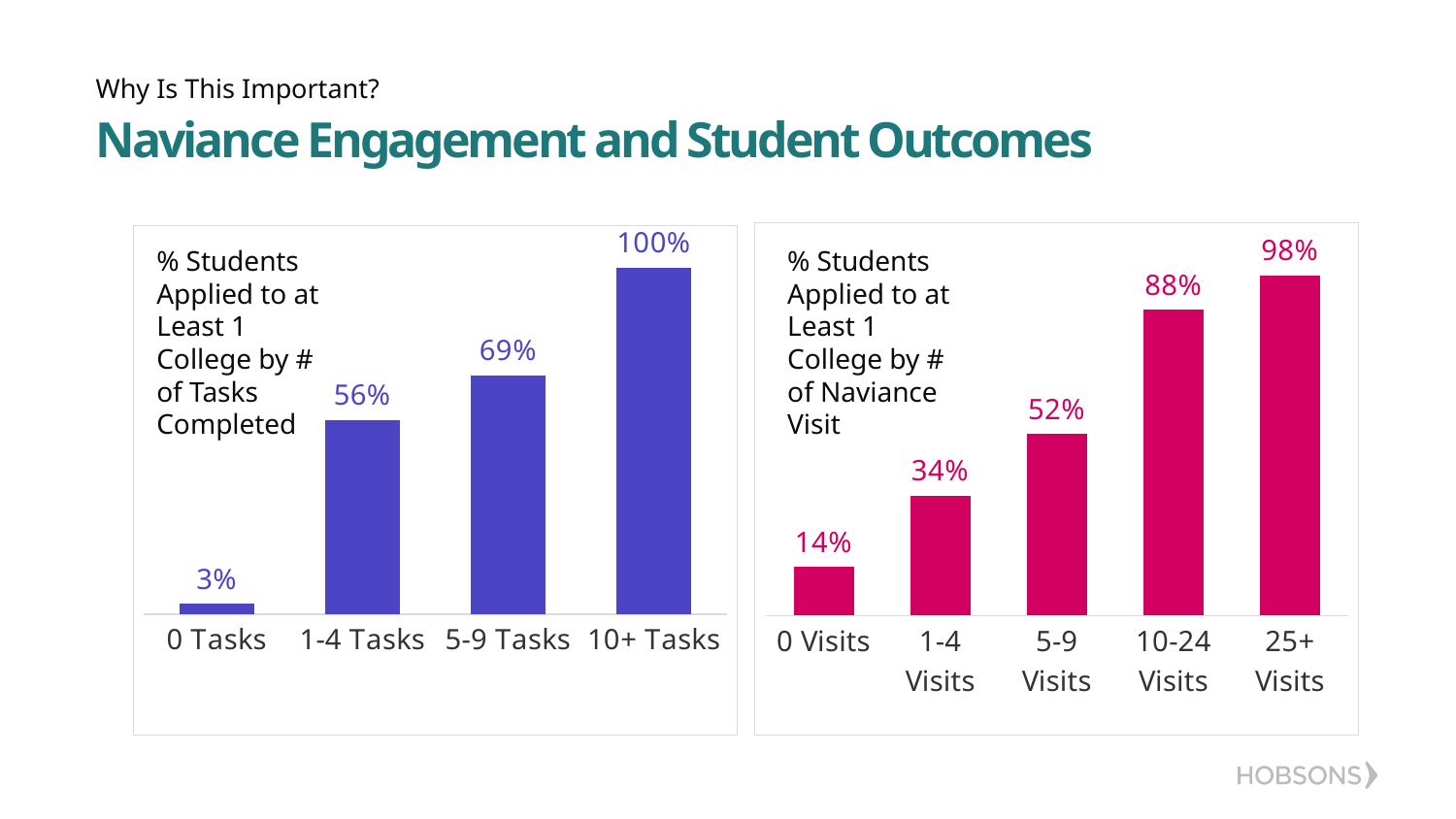
In the right chart (by # of Naviance Visit), what is the difference between the values for 10-24 Visits and 1-4 Visits? 54% In the right chart (% Students Applied to at Least 1 College by # of Naviance Visit), what is the value for 5-9 Visits? 52% What type of chart is the right chart (by # of Naviance Visit)? bar chart How many categories are shown in the left chart (by # of Tasks Completed)? 4 In the left chart (by # of Tasks Completed), which category has the lowest value? 0 Tasks In the left chart (by # of Tasks Completed), what is the difference between the values for 10+ Tasks and 5-9 Tasks? 31% What colour are the bars in the left chart (by # of Tasks Completed)? purple In the left chart (% Students Applied to at Least 1 College by # of Tasks Completed), what is the value for 1-4 Tasks? 56% In the right chart (by # of Naviance Visit), which category has the highest value? 25+ Visits In the right chart (by # of Naviance Visit), which is larger: the value for 0 Visits or the value for 1-4 Visits? 1-4 Visits How many categories are shown in the right chart (by # of Naviance Visit)? 5 In the left chart (by # of Tasks Completed), do the values rise or fall as the number of tasks increases? rise